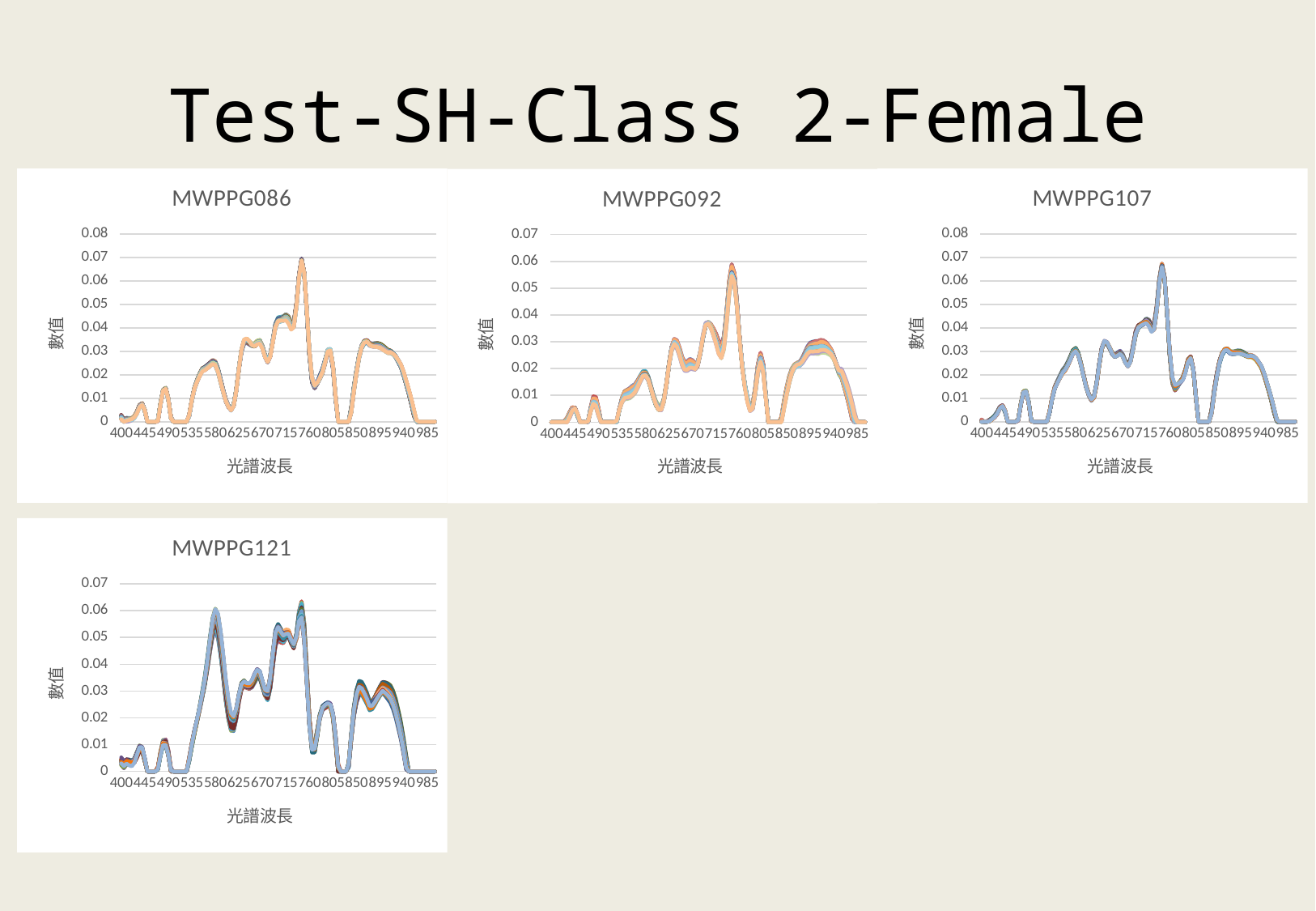
In the MWPPG086 chart, is the peak value near 760 greater or less than 0.06? greater In the MWPPG107 chart, is the peak value near 760 greater or less than 0.06? greater How many charts are shown on the slide? 4 What kind of chart is MWPPG086? line chart In the MWPPG092 chart, is the highest peak greater or less than 0.07? less How many tick labels are shown on the x axis of the MWPPG121 chart? 14 What is the title of the chart in the bottom-left of the slide? MWPPG121 What is the x-axis title of the MWPPG092 chart? 光譜波長